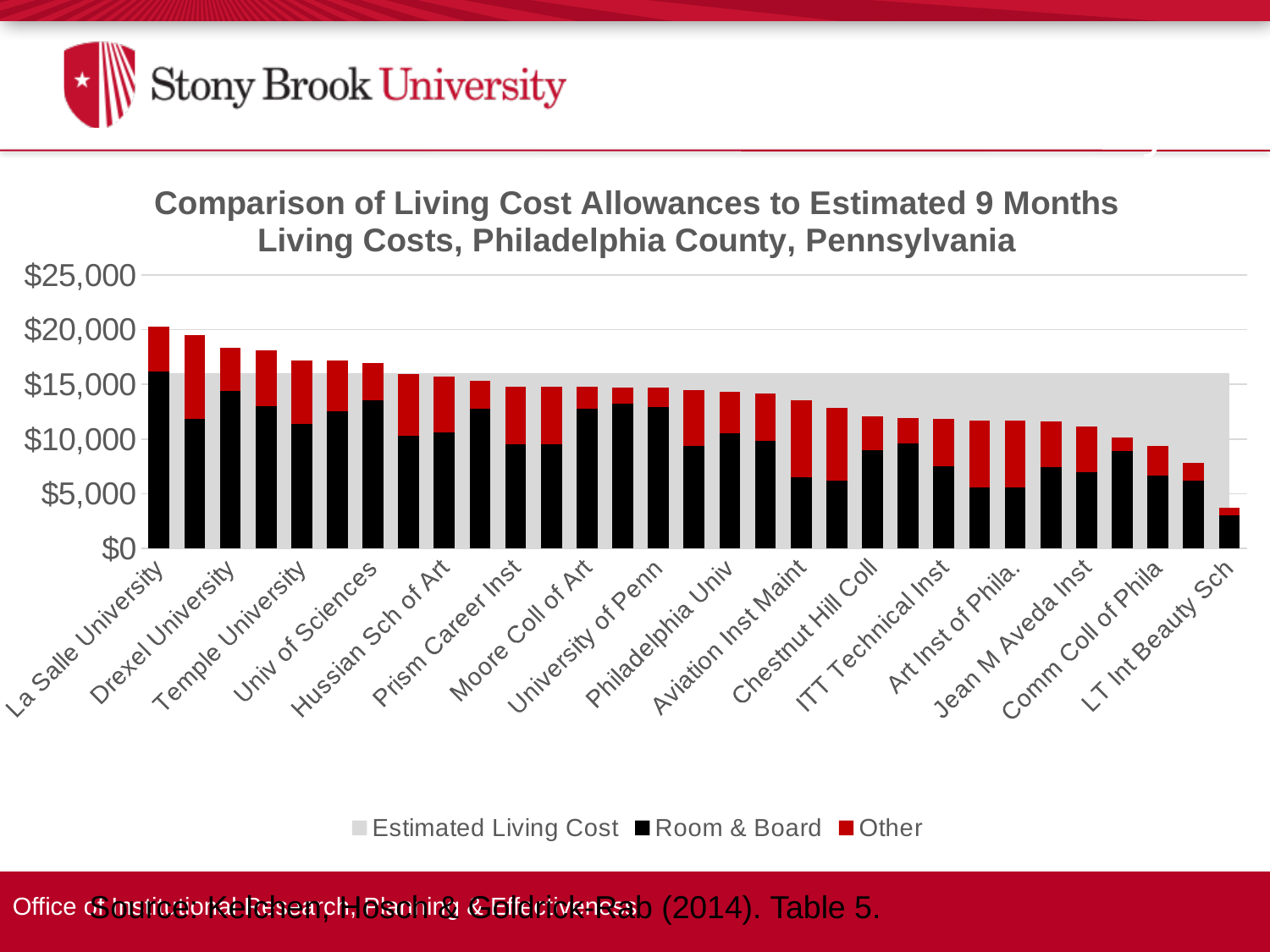
Is the total living cost allowance for LT Int Beauty Sch greater or less than $5,000? less How many series does the legend list? 3 What are the three series listed in the legend? Estimated Living Cost, Room & Board, Other Which institution has the highest total living cost allowance? La Salle University Do the total living cost allowances rise or fall from left to right along the x axis? Fall Is the total living cost allowance for Chestnut Hill Coll greater or less than $15,000? less Which institution has the lowest total living cost allowance? LT Int Beauty Sch What is the title of the chart? Comparison of Living Cost Allowances to Estimated 9 Months Living Costs, Philadelphia County, Pennsylvania Is the total living cost allowance for La Salle University greater or less than $15,000? greater What kind of chart is shown on the slide? Combination of a stacked bar chart and an area chart (stacked bars over a shaded area) Which has the larger total living cost allowance, Drexel University or Comm Coll of Phila? Drexel University